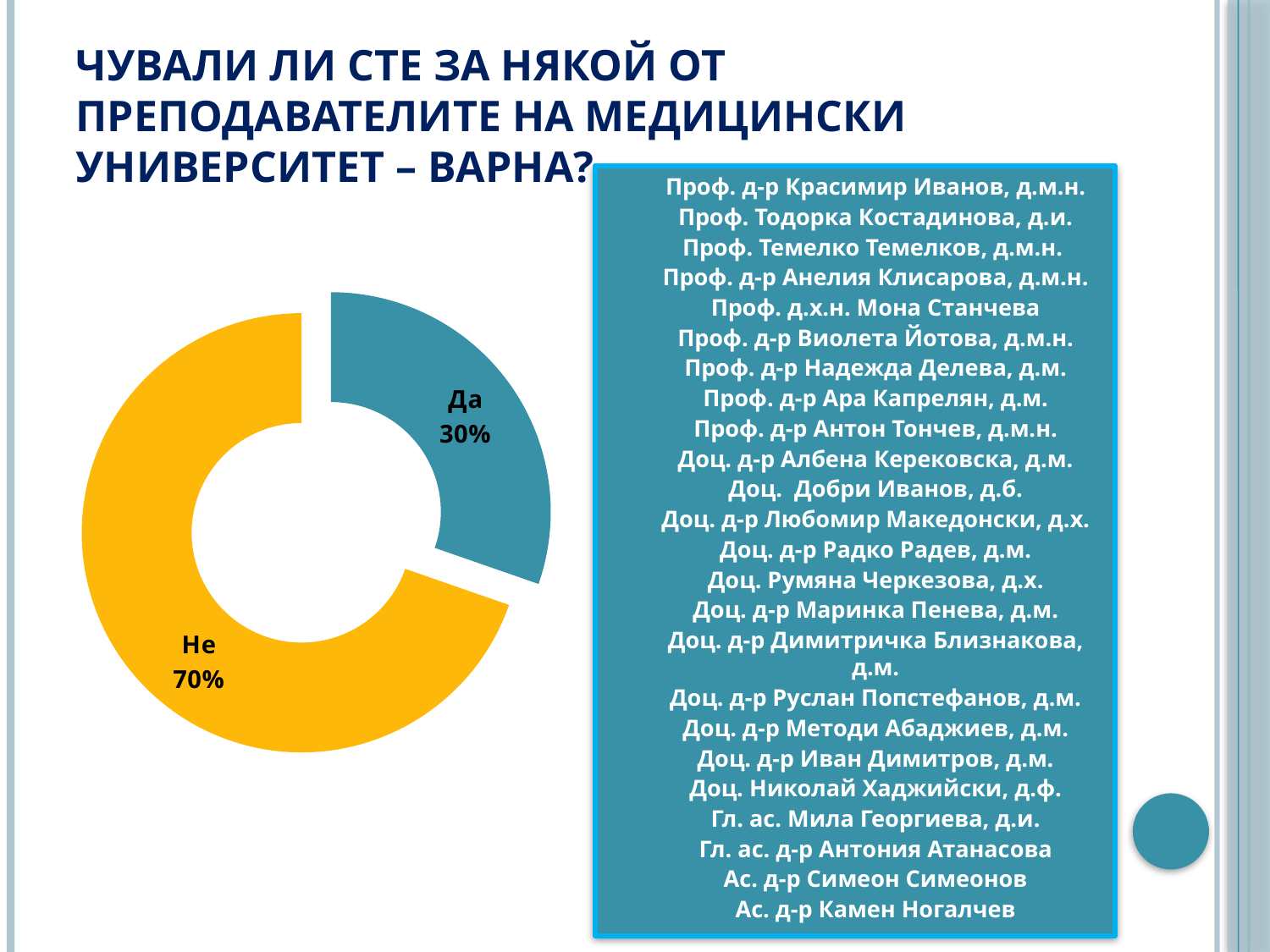
Which answer has the largest share in the chart? Не What share of respondents answered "Да" (Yes)? 30% What is the difference in percentage points between the "Не" and "Да" shares? 40 percentage points Which is larger, the share for "Да" or the share for "Не"? Не Is the share for "Да" greater or less than 50%? less What kind of chart is shown on the slide? Doughnut (pie) chart How many categories does the chart show? 2 Which answer has the smallest share in the chart? Да What colour is the "Не" slice of the chart? Yellow/orange What share of respondents answered "Не" (No)? 70% What colour is the "Да" slice of the chart? Teal/blue